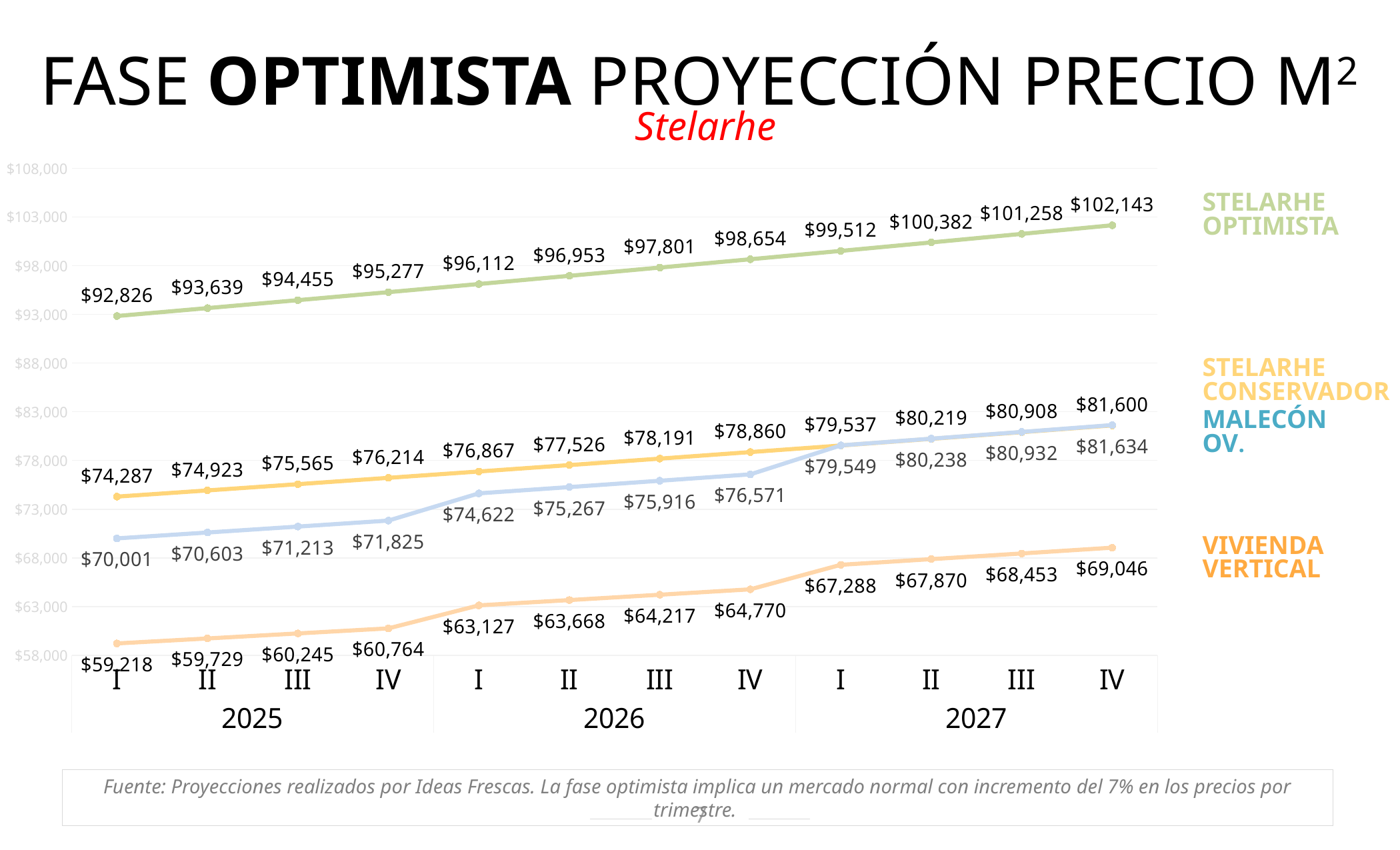
What is the Malecón OV. value for quarter I of 2026? $74,622 What is the Stelarhe Conservador value for quarter III of 2026? $78,191 Is the Vivienda Vertical value for quarter I of 2027 greater or less than $63,000? greater What is the difference between the Stelarhe Optimista value in quarter IV of 2027 and in quarter I of 2025? $9,317 How many quarters are plotted along the x axis? 12 What kind of chart is shown on the slide? Line chart What is the Vivienda Vertical value for quarter IV of 2027? $69,046 What is the Stelarhe Optimista value for quarter I of 2025? $92,826 How many series are plotted on the chart? 4 Which is larger in quarter IV of 2027: Stelarhe Conservador or Malecón OV.? Malecón OV. Which series has the highest value in quarter IV of 2027? Stelarhe Optimista Which series has the lowest value in quarter I of 2025? Vivienda Vertical